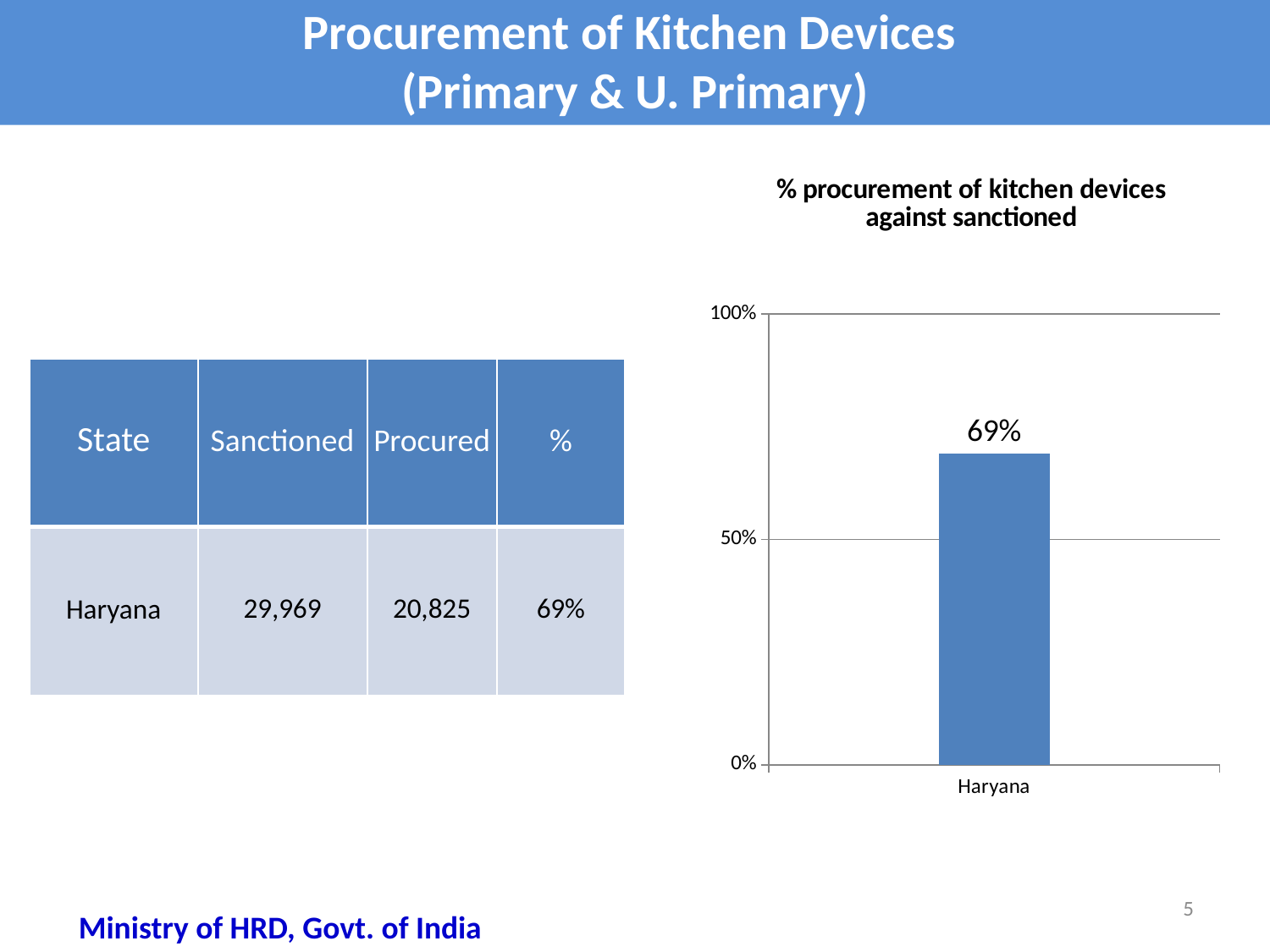
What is the title of the chart? % procurement of kitchen devices against sanctioned What is the value for Haryana in the chart? 69% Is the value for Haryana greater or less than 50%? greater How many categories are plotted in the chart? 1 What kind of chart is shown on the slide? bar chart Is the value for Haryana greater or less than 100%? less Which state is shown on the x axis of the chart? Haryana What is the highest value shown on the chart's y axis? 100%